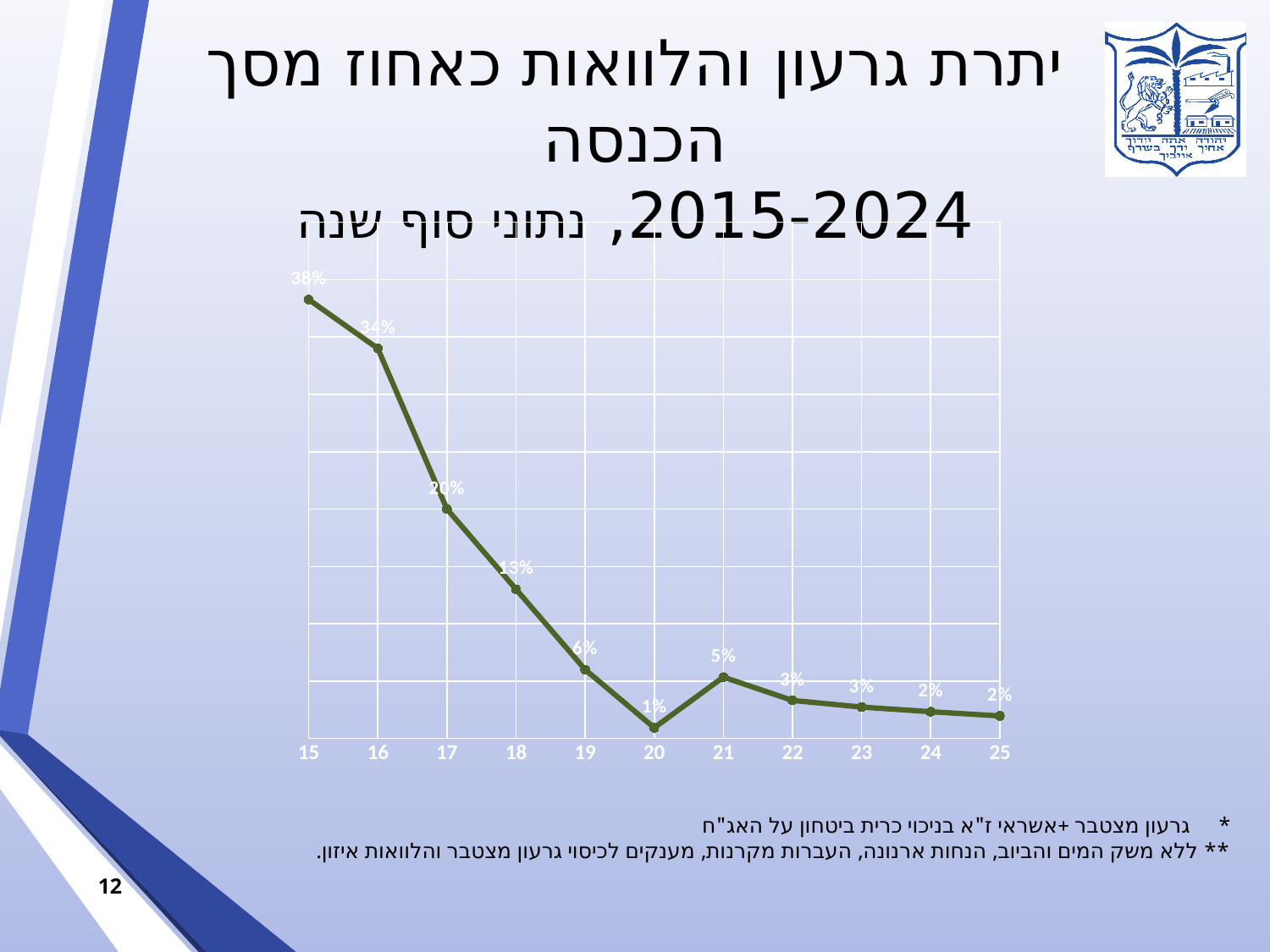
What is the value for 20? 1% Which x-axis category has the highest value? 15 How many data points are plotted on the chart? 11 Which x-axis category has the lowest value? 20 What is the value for 15? 38% What is the value for 21? 5% What is the value for 17? 20% Which has a larger value, 18 or 19? 18 What type of chart is shown on the slide? line chart What is the first x-axis label on the chart? 15 What is the difference between the values for 16 and 17? 14% Do the values generally rise or fall from 15 to 20? fall